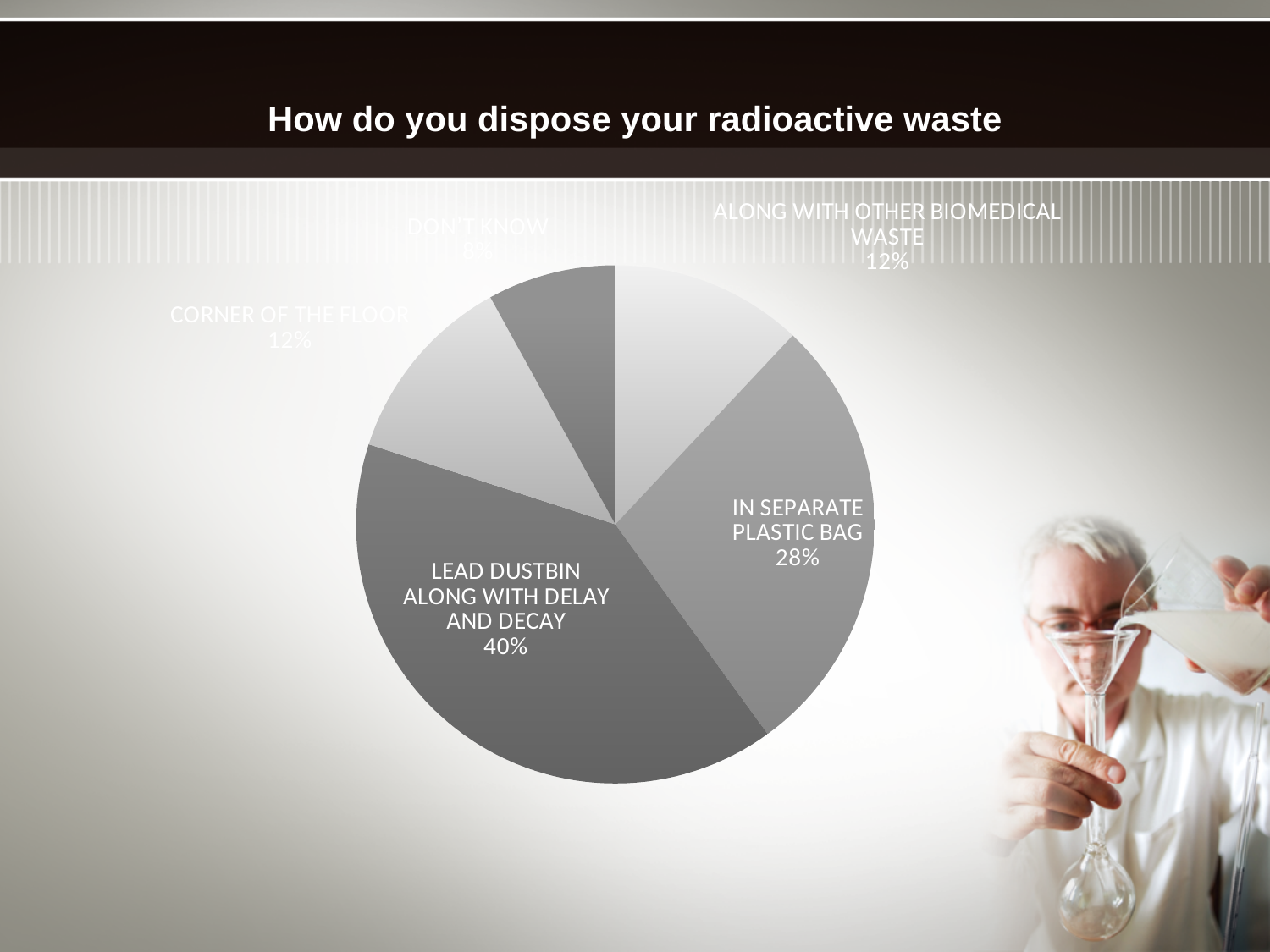
Which disposal method has the largest share of the pie? Lead dustbin along with delay and decay How many slices does the pie chart have? 5 Which response has the smallest share of the pie? Don't know What is the title of the chart? How do you dispose your radioactive waste Which is larger: the share for 'In separate plastic bag' or the share for 'Corner of the floor'? In separate plastic bag What percentage of respondents answered 'Don't know'? 8% What percentage of respondents dispose of radioactive waste along with other biomedical waste? 12% What percentage of respondents dispose of radioactive waste in a lead dustbin along with delay and decay? 40% What kind of chart is shown on the slide? Pie chart What percentage of respondents dispose of radioactive waste in a separate plastic bag? 28% What is the combined share of 'Corner of the floor' and 'Along with other biomedical waste'? 24% What is the difference in percentage points between 'Lead dustbin along with delay and decay' and 'In separate plastic bag'? 12